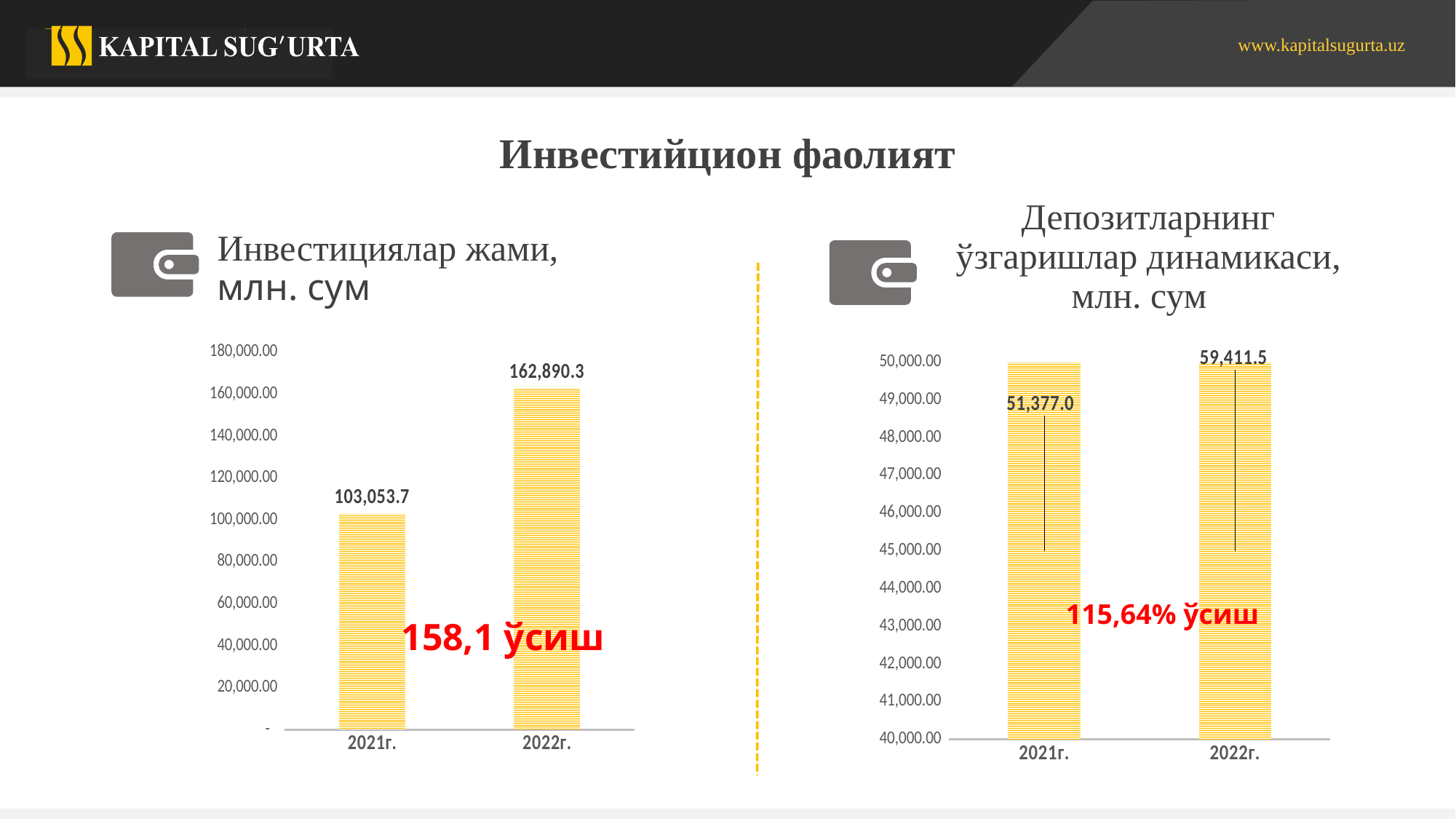
In the left chart (Инвестициялар жами, млн. сум), do the values rise or fall from 2021г. to 2022г.? rise In the right chart (Депозитларнинг ўзгаришлар динамикаси, млн. сум), what is the difference between the 2022г. and 2021г. values? 8,034.5 In the left chart (Инвестициялар жами, млн. сум), what is the difference between the 2022г. and 2021г. values? 59,836.6 In the right chart (Депозитларнинг ўзгаришлар динамикаси, млн. сум), which year has the lowest value? 2021г. In the left chart (Инвестициялар жами, млн. сум), how many years are plotted? 2 In the left chart (Инвестициялар жами, млн. сум), what is the value for 2021г.? 103,053.7 What type of chart is the right chart (Депозитларнинг ўзгаришлар динамикаси, млн. сум)? bar chart In the right chart (Депозитларнинг ўзгаришлар динамикаси, млн. сум), what is the value for 2021г.? 51,377.0 In the left chart (Инвестициялар жами, млн. сум), is the value for 2021г. greater or less than 120,000.00? less In the right chart (Депозитларнинг ўзгаришлар динамикаси, млн. сум), what is the value for 2022г.? 59,411.5 In the left chart (Инвестициялар жами, млн. сум), which year has the highest value? 2022г. In the left chart (Инвестициялар жами, млн. сум), what is the value for 2022г.? 162,890.3